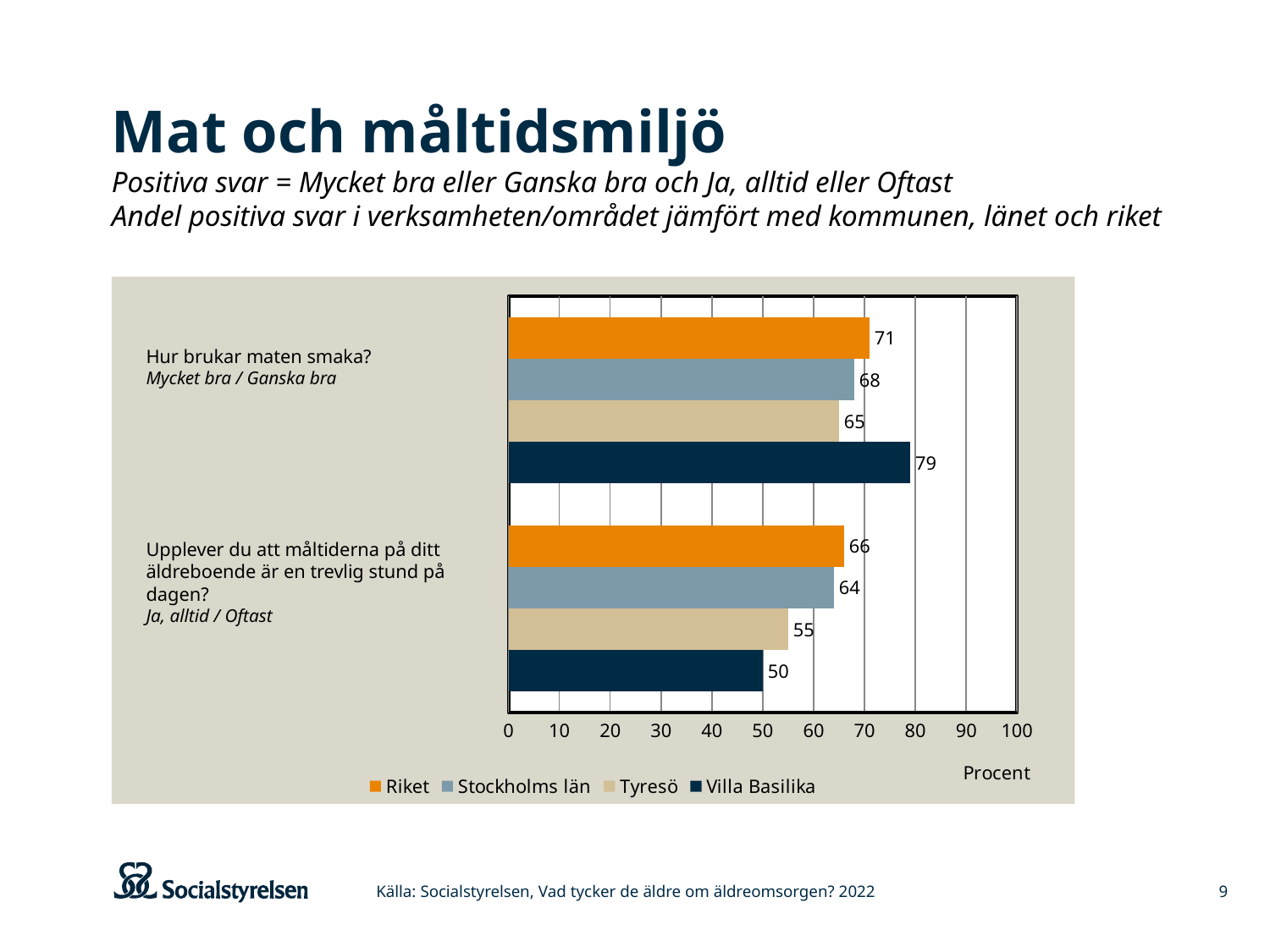
What unit label is shown below the x axis? Procent What is the difference between Riket and Villa Basilika for "Upplever du att måltiderna på ditt äldreboende är en trevlig stund på dagen?"? 16 What is the value for Villa Basilika for "Hur brukar maten smaka?"? 79 Which series has the highest value for "Hur brukar maten smaka?"? Villa Basilika What kind of chart is shown on the slide? Bar chart Which is larger for "Upplever du att måltiderna på ditt äldreboende är en trevlig stund på dagen?": Stockholms län or Tyresö? Stockholms län What is the value for Tyresö for "Upplever du att måltiderna på ditt äldreboende är en trevlig stund på dagen?"? 55 How many question categories are shown on the chart? 2 What is the difference between Villa Basilika and Riket for "Hur brukar maten smaka?"? 8 How many series does the legend list? 4 Which series has the lowest value for "Upplever du att måltiderna på ditt äldreboende är en trevlig stund på dagen?"? Villa Basilika What is the value for Riket for "Hur brukar maten smaka?"? 71